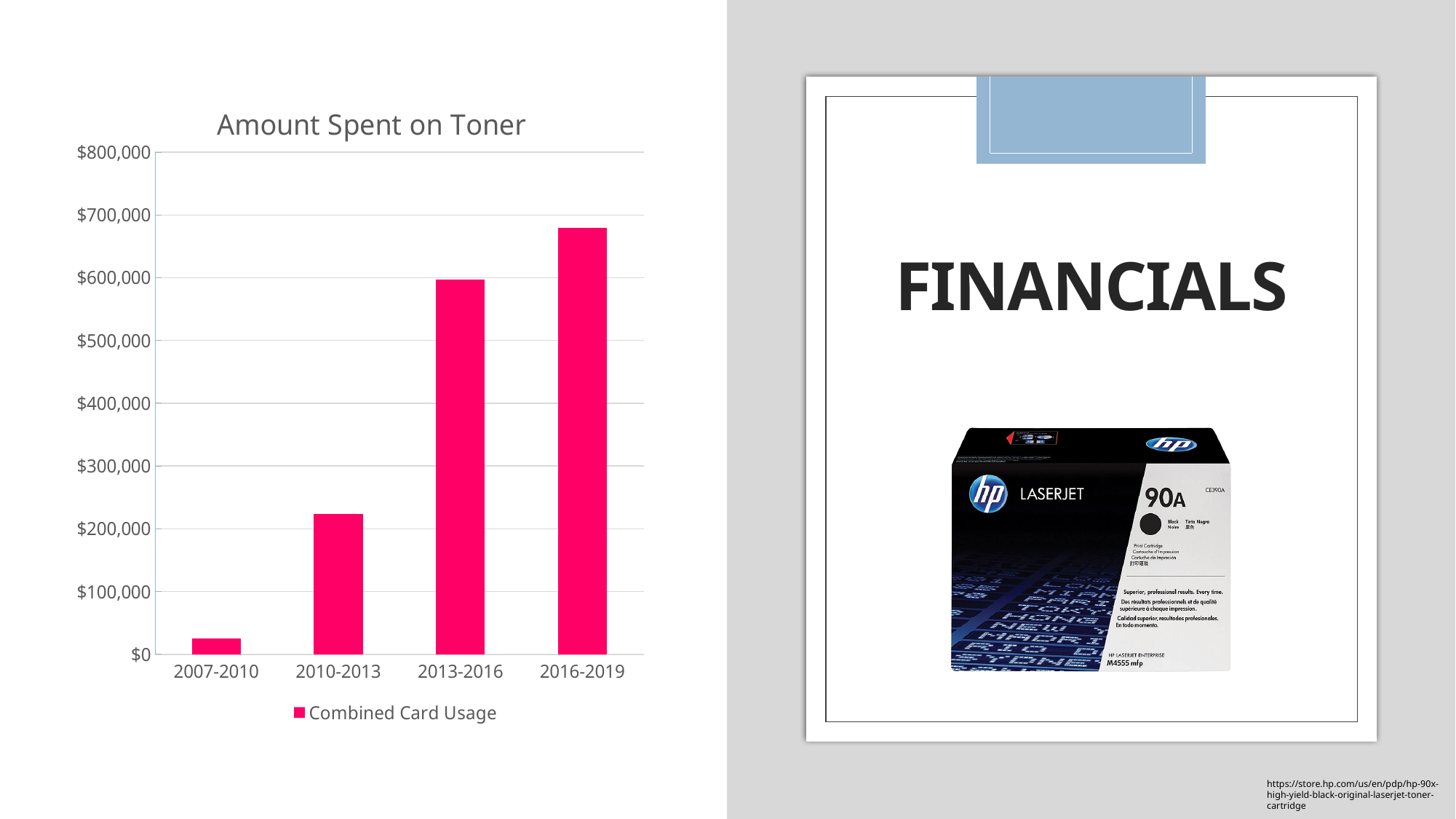
Is the value for 2010-2013 greater or less than $200,000? greater Which period has the lowest amount spent on toner? 2007-2010 How many series does the legend list? 1 Which is larger, the value for 2010-2013 or the value for 2013-2016? 2013-2016 Do the values rise or fall from 2007-2010 to 2016-2019? rise What is the title of the chart? Amount Spent on Toner What is the name of the series shown in the legend? Combined Card Usage What type of chart is shown on the slide? bar chart How many time periods are shown on the x axis? 4 Is the value for 2016-2019 greater or less than $700,000? less Which period has the highest amount spent on toner? 2016-2019 Is the value for 2007-2010 greater or less than $100,000? less